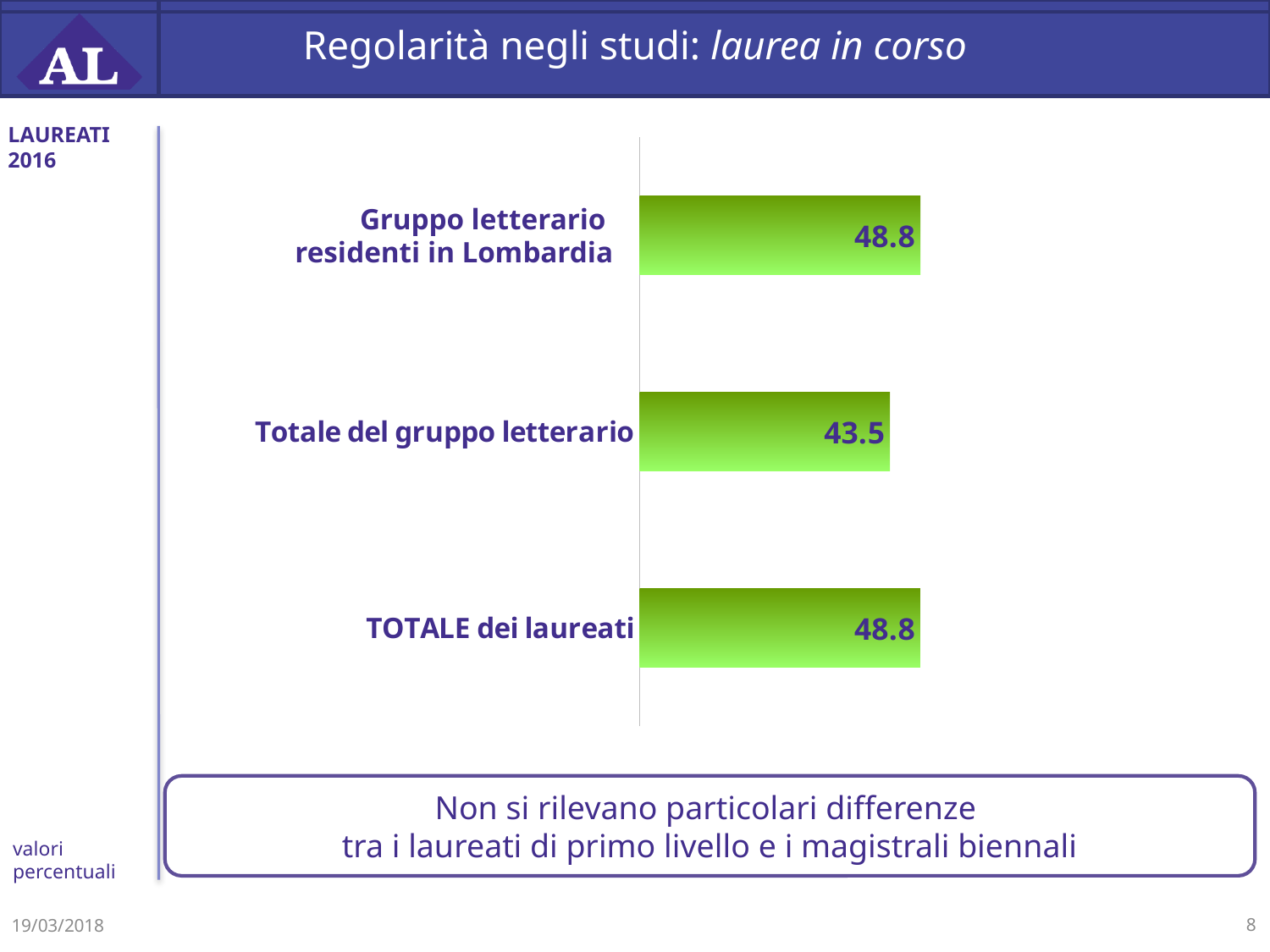
What is the value for TOTALE dei laureati? 48.8 What colour are the bars in the chart? Green Which category has the lowest value? Totale del gruppo letterario What is the title of the slide containing the chart? Regolarità negli studi: laurea in corso Do Gruppo letterario residenti in Lombardia and TOTALE dei laureati have the same value? Yes What is the value for Totale del gruppo letterario? 43.5 What is the value for Gruppo letterario residenti in Lombardia? 48.8 How many categories are shown in the chart? 3 What kind of chart is shown on the slide? Bar chart What is the difference between the values for Gruppo letterario residenti in Lombardia and Totale del gruppo letterario? 5.3 Which is larger: the value for TOTALE dei laureati or the value for Totale del gruppo letterario? TOTALE dei laureati